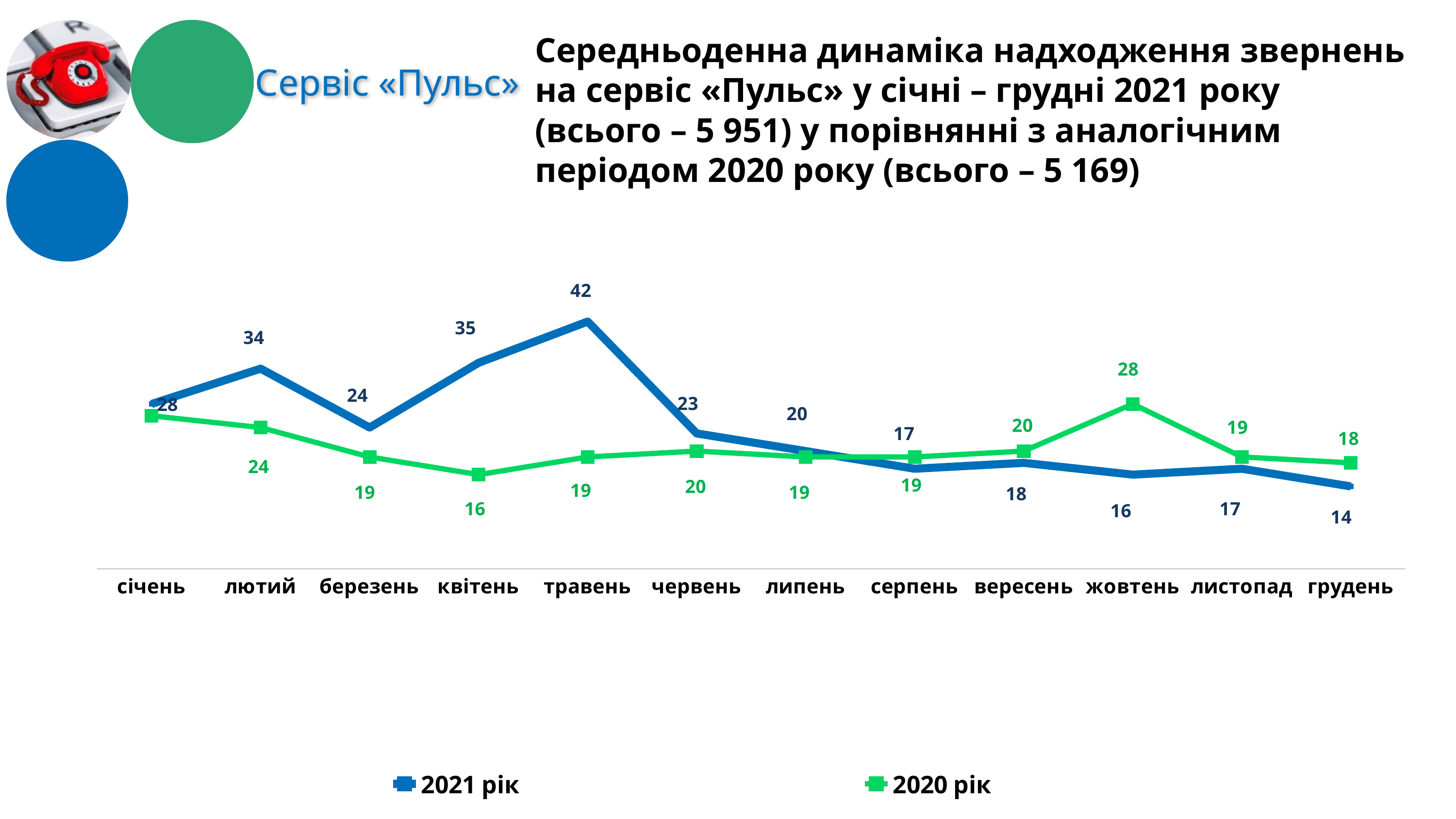
What is the difference between the 2021 рік and 2020 рік values for травень? 23 How many series does the legend list? 2 Which month has the highest value in the 2021 рік series? травень Which month has the lowest value in the 2021 рік series? грудень Which month has the highest value in the 2020 рік series? жовтень What is the value for грудень in the 2021 рік series? 14 What is the value for травень in the 2021 рік series? 42 What kind of chart is shown on the slide? line chart What is the value for жовтень in the 2020 рік series? 28 How many months are shown on the x axis? 12 What is the value for квітень in the 2020 рік series? 16 Which series has the larger value for жовтень, 2021 рік or 2020 рік? 2020 рік